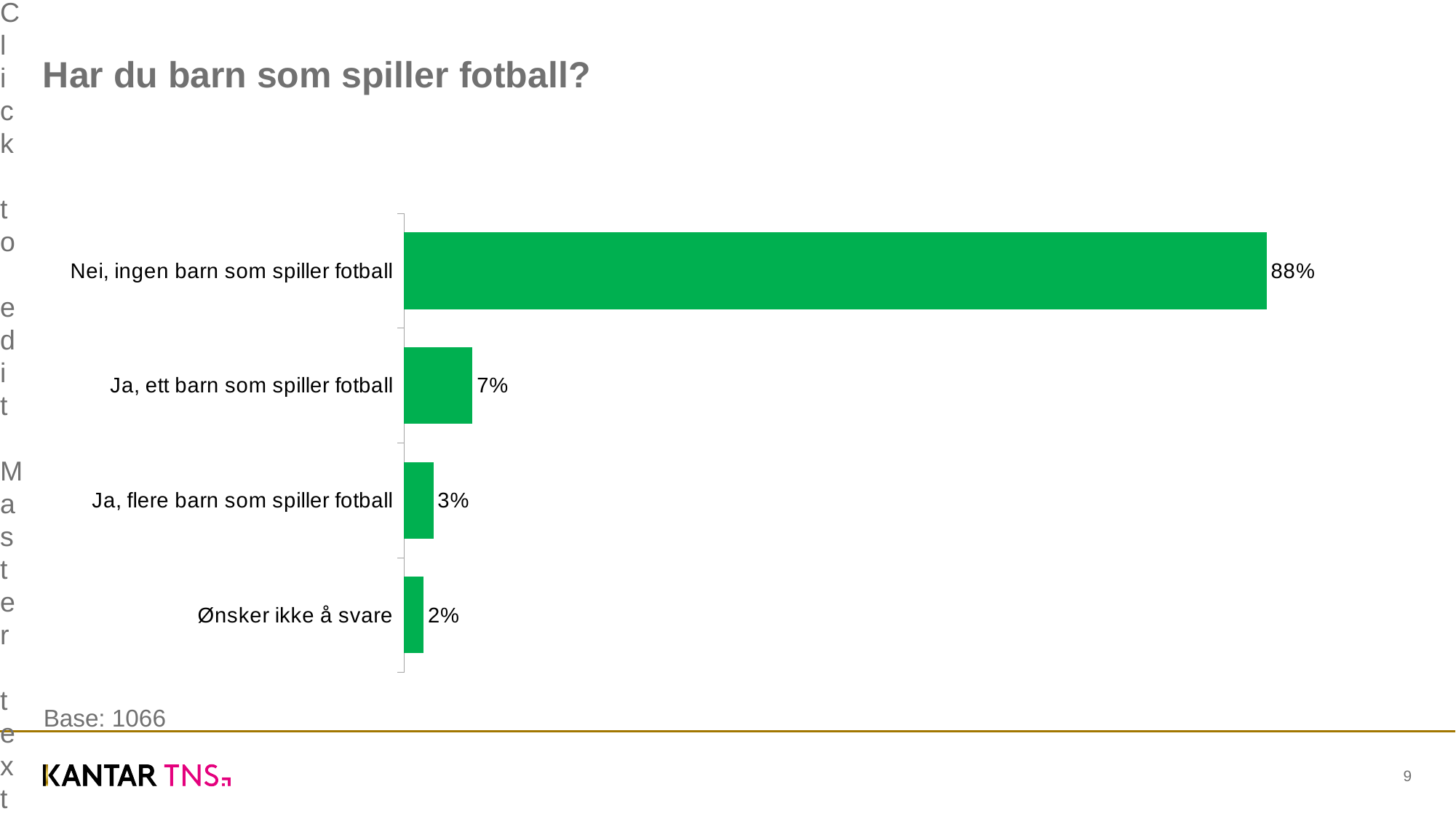
What is the value for "Ja, flere barn som spiller fotball"? 3% Which category has the highest value? Nei, ingen barn som spiller fotball What is the value for "Ja, ett barn som spiller fotball"? 7% Which category has the lowest value? Ønsker ikke å svare What percentage of respondents answered "Nei, ingen barn som spiller fotball"? 88% What is the base (number of respondents) stated on the slide? 1066 What percentage of respondents chose "Ønsker ikke å svare"? 2% What kind of chart is shown on the slide? Bar chart How many categories are shown in the chart? 4 Which is larger: "Ja, flere barn som spiller fotball" or "Ønsker ikke å svare"? Ja, flere barn som spiller fotball What is the difference between "Nei, ingen barn som spiller fotball" and "Ja, ett barn som spiller fotball"? 81% What is the difference between "Ja, ett barn som spiller fotball" and "Ja, flere barn som spiller fotball"? 4%